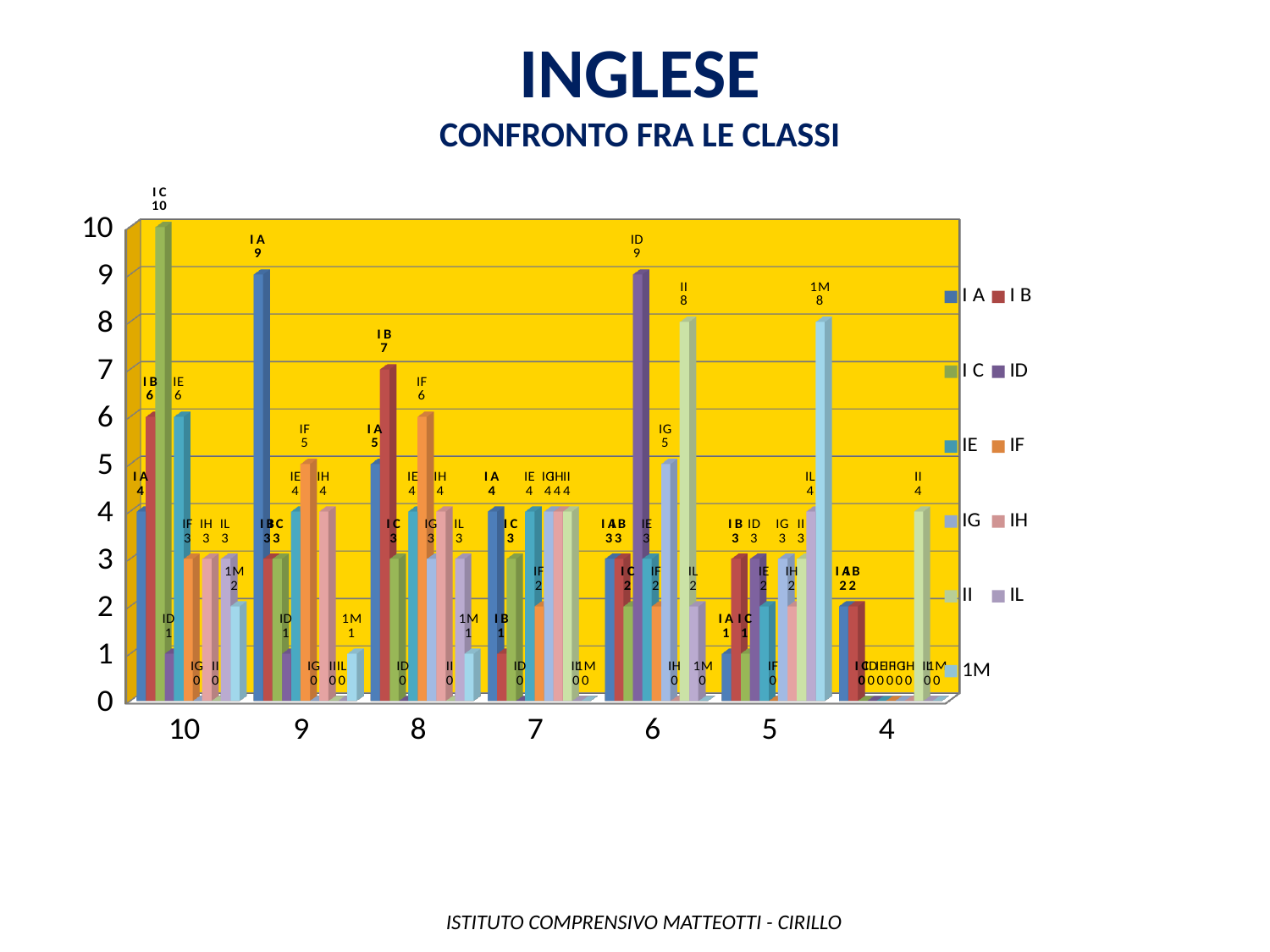
How many series does the legend list? 11 Which is larger at grade 8: the value for I B or the value for I F? I B What is the value for class I A at grade 9? 9 What is the value for class I C at grade 10? 10 What is the value for class 1M at grade 5? 8 What is the value for class ID at grade 6? 9 Which class has the highest value at grade 10? I C What kind of chart is shown on the slide? bar chart How many grade categories are shown on the x axis? 7 What is the difference between the values of I C and I B at grade 10? 4 What is the subtitle of the chart below INGLESE? CONFRONTO FRA LE CLASSI Which class has the highest value at grade 9? I A